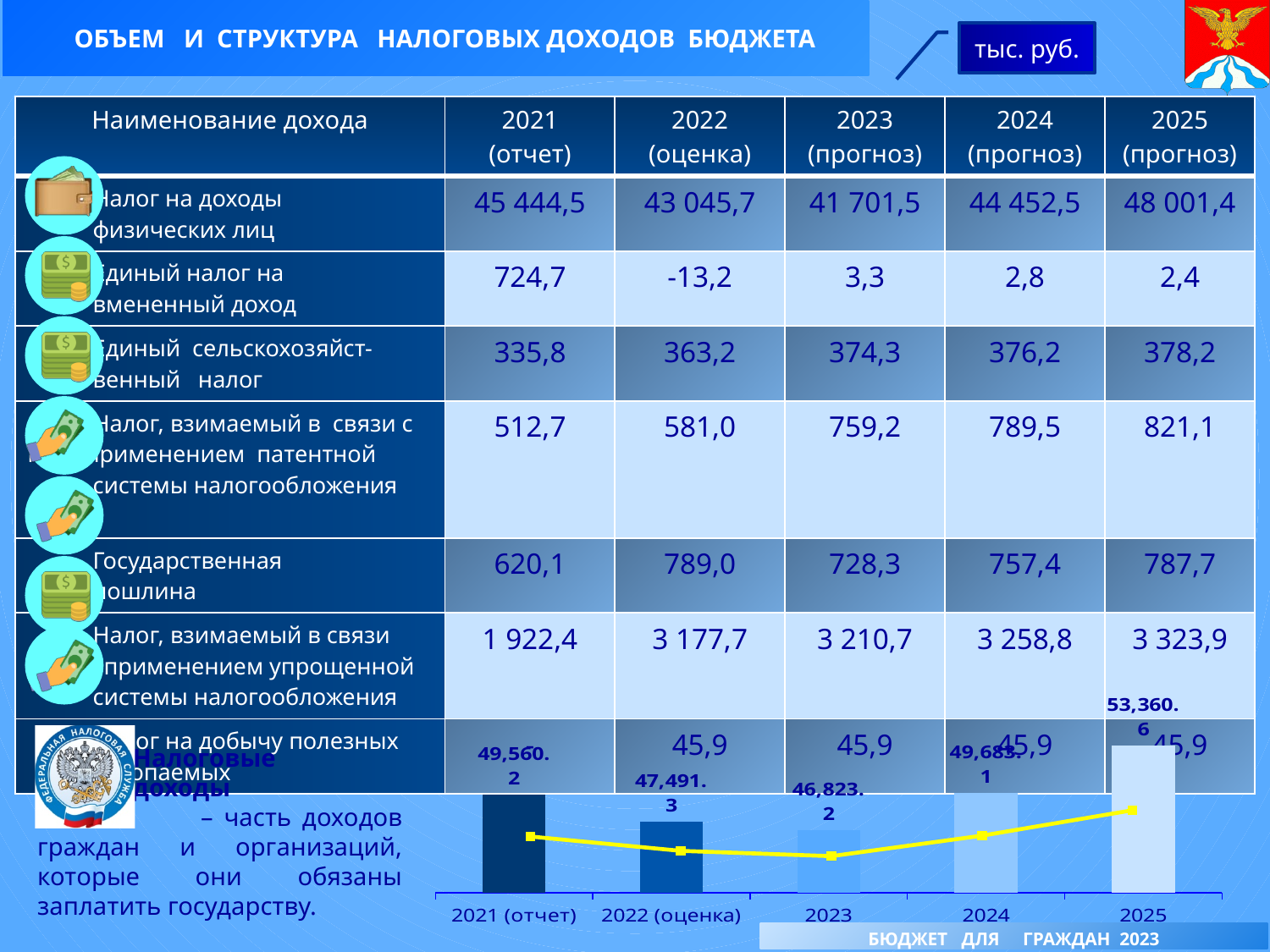
In the chart at the bottom of the slide, what is the value for 2023? 46,823.2 In the chart at the bottom of the slide, what is the difference between the values for 2025 and 2021 (отчет)? 3,800.4 In the chart at the bottom of the slide, what is the value for 2022 (оценка)? 47,491.3 In the chart at the bottom of the slide, what is the difference between the values for 2021 (отчет) and 2022 (оценка)? 2,068.9 In the chart at the bottom of the slide, how do the values change from 2023 to 2025? They rise In the chart at the bottom of the slide, what is the value for 2025? 53,360.6 In the chart at the bottom of the slide, what is the value for 2021 (отчет)? 49,560.2 In the chart at the bottom of the slide, which is larger: the value for 2022 (оценка) or the value for 2024? 2024 In the chart at the bottom of the slide, which year has the lowest value? 2023 What kind of chart is shown at the bottom of the slide? Bar chart with a line overlay In the chart at the bottom of the slide, which year has the highest value? 2025 How many categories (years) are shown in the chart at the bottom of the slide? 5